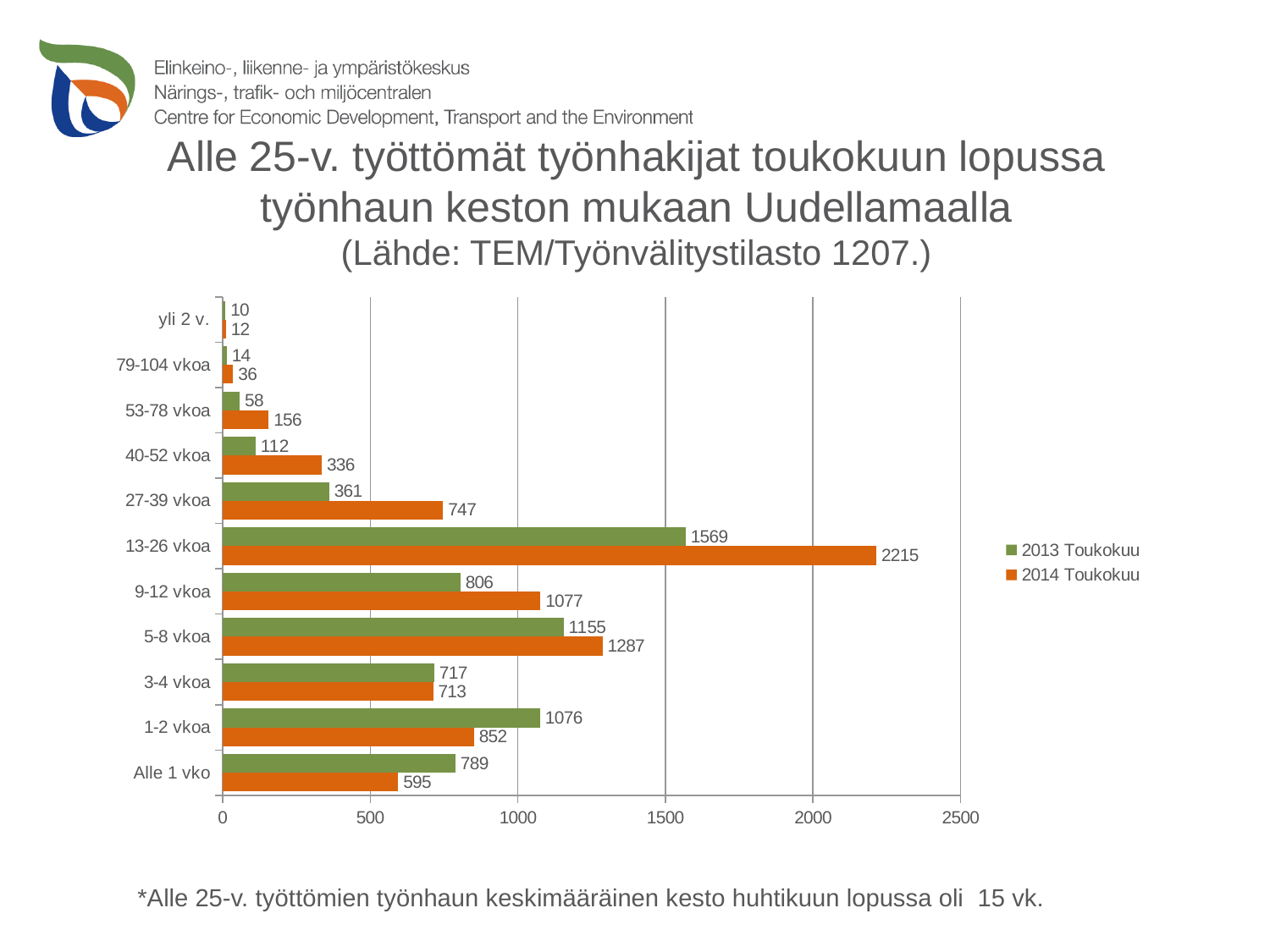
Which category has the lowest value in the 2014 Toukokuu series? yli 2 v. What is the value for 13-26 vkoa in the 2014 Toukokuu series? 2215 How many series does the legend list? 2 What is the difference between the 2013 Toukokuu and 2014 Toukokuu values for 1-2 vkoa? 224 Which category has the highest value in the 2013 Toukokuu series? 13-26 vkoa What kind of chart is shown on the slide? bar chart Is the 2014 Toukokuu value for 5-8 vkoa greater or less than 1000? greater How many categories are shown on the chart? 11 What is the value for Alle 1 vko in the 2014 Toukokuu series? 595 Which is larger for 9-12 vkoa: the 2013 Toukokuu value or the 2014 Toukokuu value? 2014 Toukokuu What is the difference between the 2014 Toukokuu and 2013 Toukokuu values for 13-26 vkoa? 646 What is the value for 5-8 vkoa in the 2013 Toukokuu series? 1155